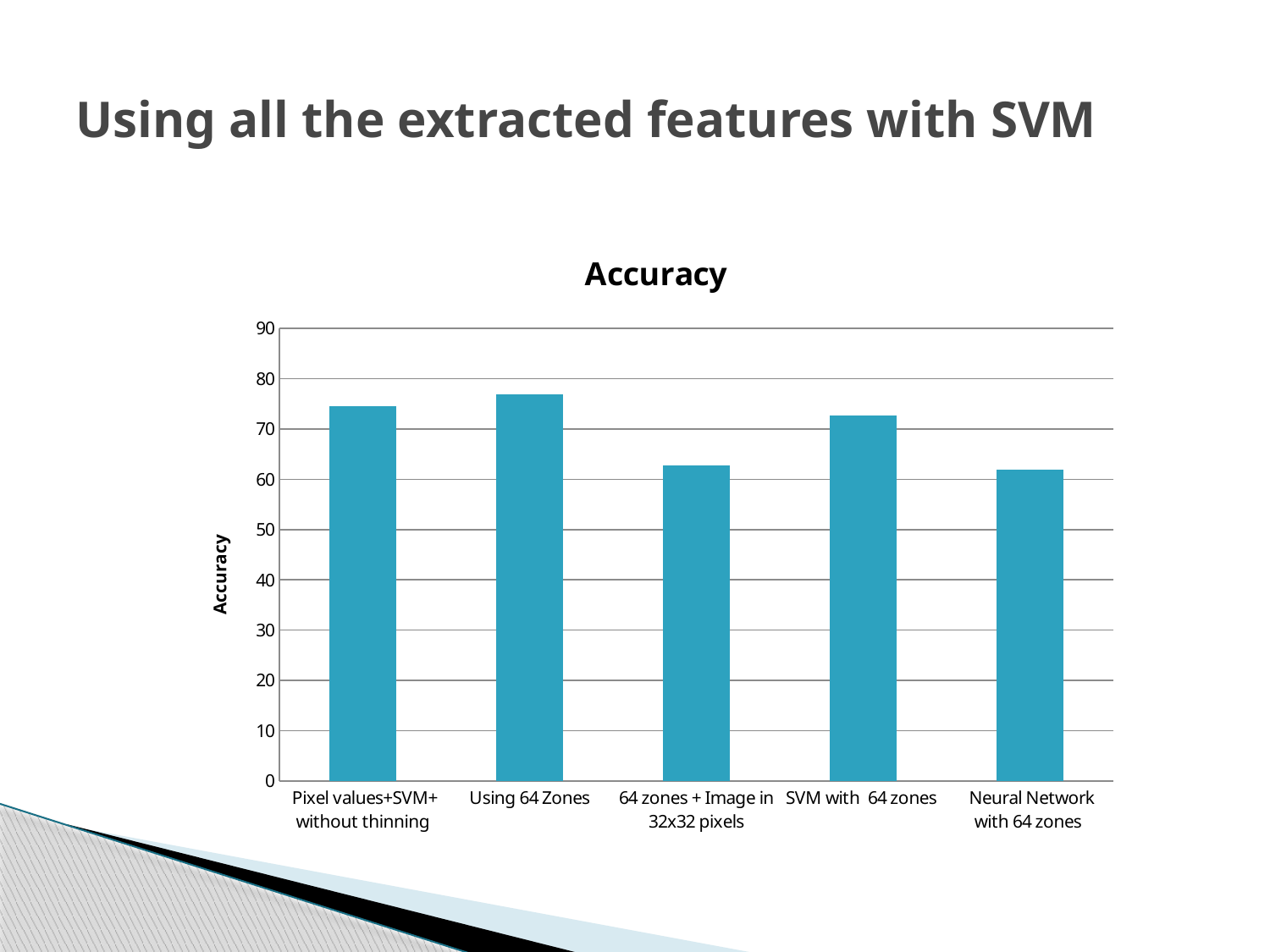
Which is larger, the value for SVM with 64 zones or the value for Neural Network with 64 zones? SVM with 64 zones How many categories are shown on the x axis of the chart? 5 Is the value for SVM with 64 zones greater or less than 70? greater What kind of chart is shown on the slide? bar chart Which is larger, the value for Using 64 Zones or the value for 64 zones + Image in 32x32 pixels? Using 64 Zones Is the value for 64 zones + Image in 32x32 pixels greater or less than 70? less Is the value for Pixel values+SVM+without thinning greater or less than 70? greater Which category has the highest accuracy? Using 64 Zones What is the label on the vertical axis of the chart? Accuracy What is the title of the chart? Accuracy